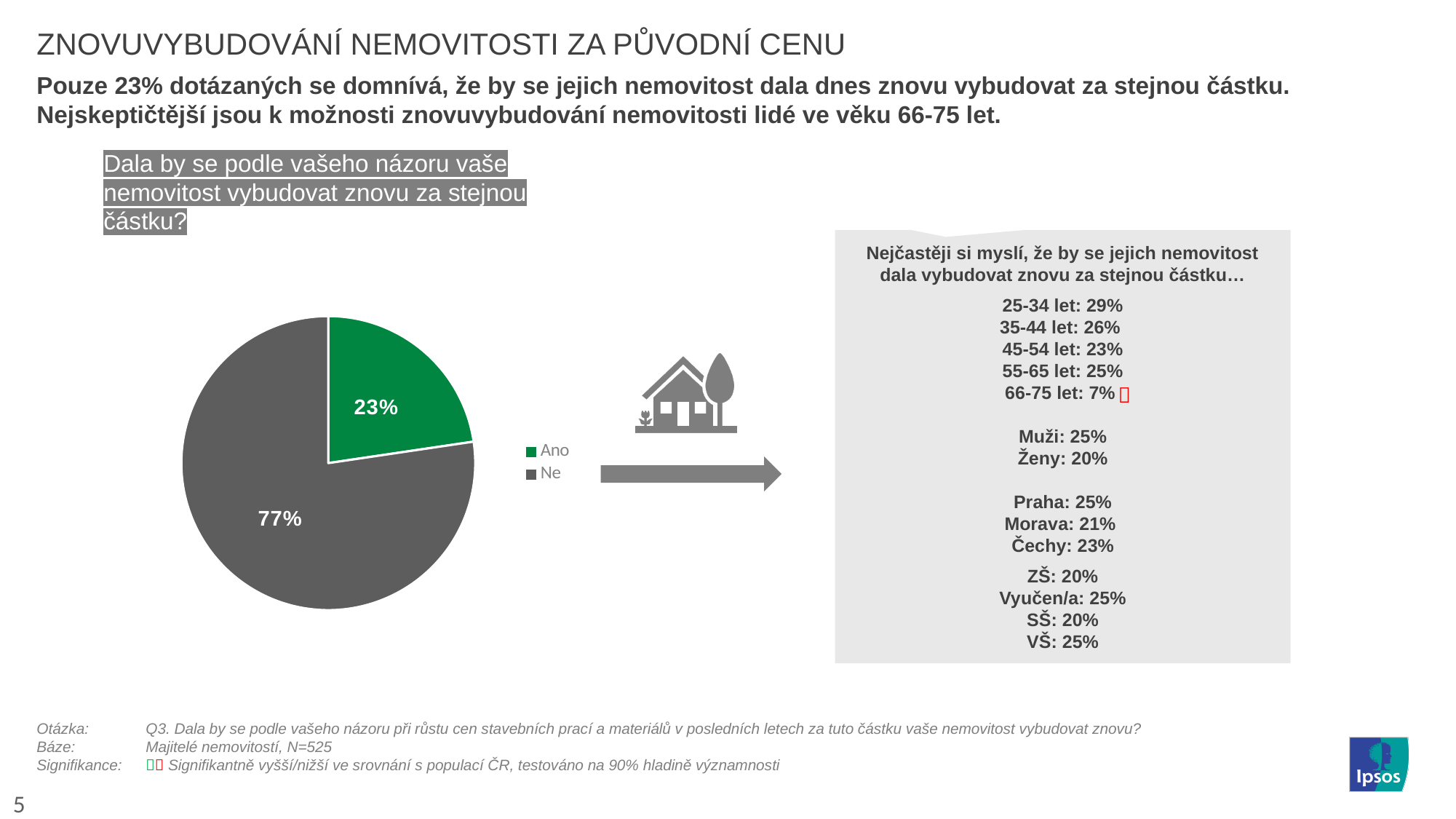
How many slices does the pie chart have? 2 How many entries does the pie chart's legend list? 2 What kind of chart is shown on the slide? pie chart What percentage of the pie chart is the "Ne" slice? 77% What colour is the "Ano" slice in the pie chart? green Which is larger in the pie chart, "Ano" or "Ne"? Ne What colour is the "Ne" slice in the pie chart? grey Which slice of the pie chart is the smallest? Ano What is the difference in percentage points between the "Ne" and "Ano" slices of the pie chart? 54 Which slice of the pie chart is the largest? Ne What percentage of the pie chart is the "Ano" slice? 23% What share of the pie does the "Ano" slice represent? 23%